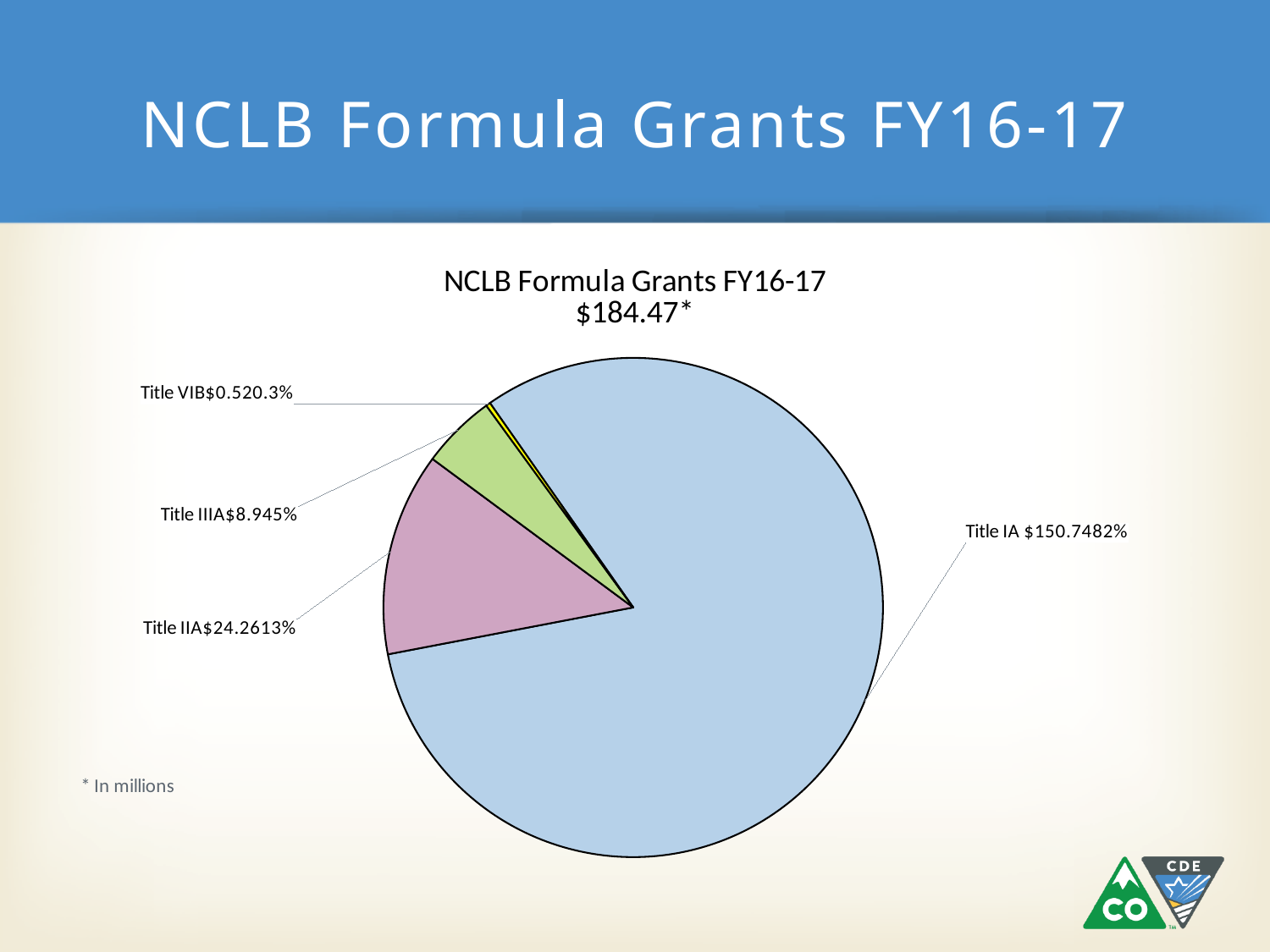
Which slice is larger, Title IIIA or Title VIB? Title IIIA What total amount is shown in the chart title? $184.47 Which slice is the largest in the pie chart? Title IA How many slices does the pie chart have? 4 What kind of chart is shown on the slide? pie chart Which slice is larger, Title IIA or Title IIIA? Title IIA What share of the pie does the Title IA slice represent? 82% What share of the pie does the Title IIA slice represent? 13% Which slice is the smallest in the pie chart? Title VIB What share of the pie does the Title VIB slice represent? 0.3% According to the footnote, what unit are the values in? In millions What is the title of the chart? NCLB Formula Grants FY16-17 $184.47*